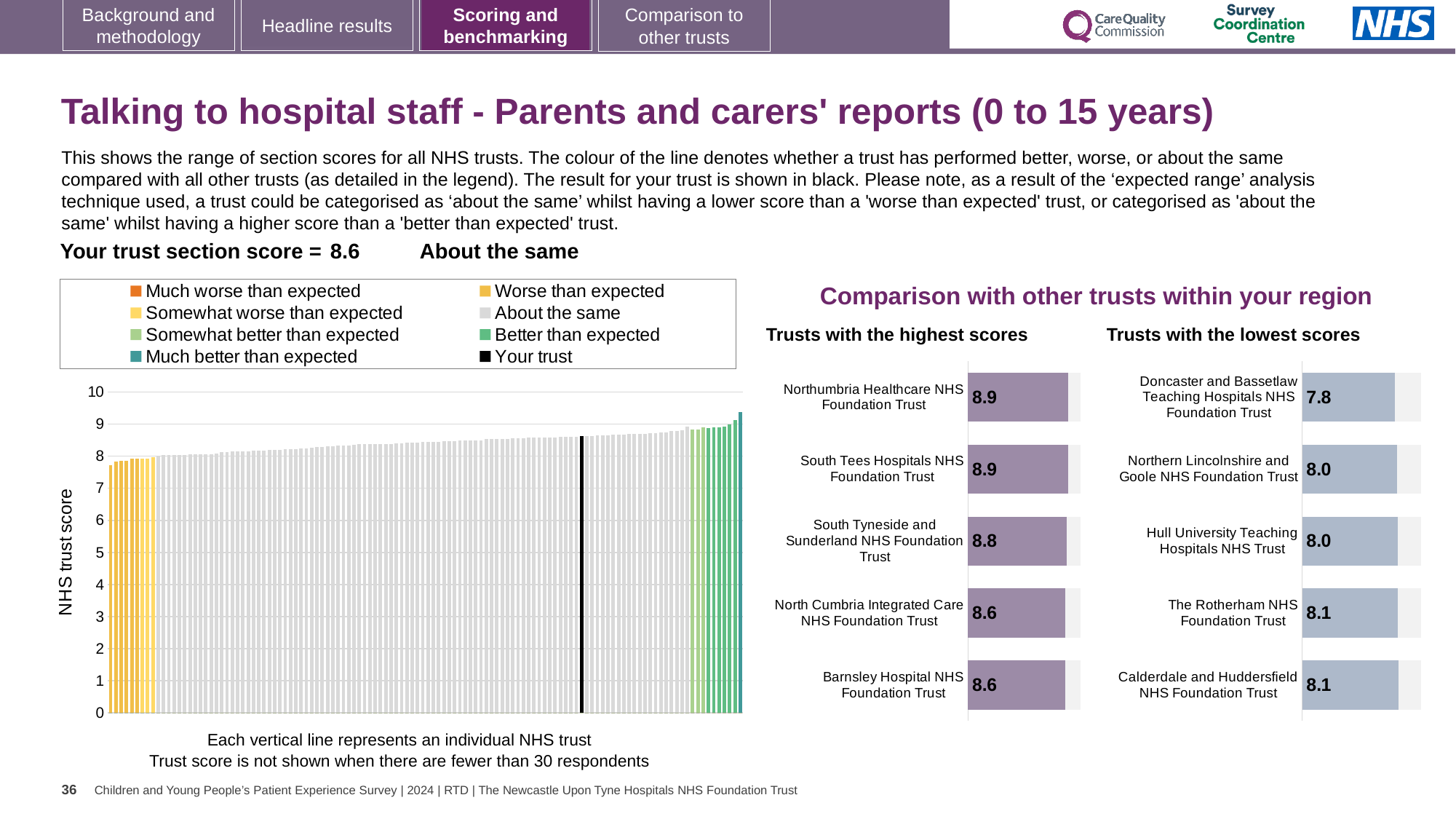
In the 'Trusts with the highest scores' chart, what is the score for South Tyneside and Sunderland NHS Foundation Trust? 8.8 What kind of chart is the main 'NHS trust score' chart on the left of the slide? Bar chart In the 'Trusts with the lowest scores' chart, how much higher is Calderdale and Huddersfield NHS Foundation Trust's score than Doncaster and Bassetlaw Teaching Hospitals NHS Foundation Trust's score? 0.3 In the main 'NHS trust score' chart, is the value for the black 'Your trust' bar greater or less than 8? greater In the 'Trusts with the lowest scores' chart, which trust has the lowest score? Doncaster and Bassetlaw Teaching Hospitals NHS Foundation Trust How many entries does the legend of the main 'NHS trust score' chart list? 8 Which has the higher score: South Tees Hospitals NHS Foundation Trust in the 'highest scores' chart or Hull University Teaching Hospitals NHS Trust in the 'lowest scores' chart? South Tees Hospitals NHS Foundation Trust In the 'Trusts with the lowest scores' chart, what is the score for Doncaster and Bassetlaw Teaching Hospitals NHS Foundation Trust? 7.8 In the 'Trusts with the highest scores' chart, what is the score for Northumbria Healthcare NHS Foundation Trust? 8.9 In the 'Trusts with the lowest scores' chart, what is the score for The Rotherham NHS Foundation Trust? 8.1 In the 'Trusts with the highest scores' chart, what is the difference between the scores of Northumbria Healthcare NHS Foundation Trust and Barnsley Hospital NHS Foundation Trust? 0.3 How many trusts are shown in the 'Trusts with the highest scores' chart? 5